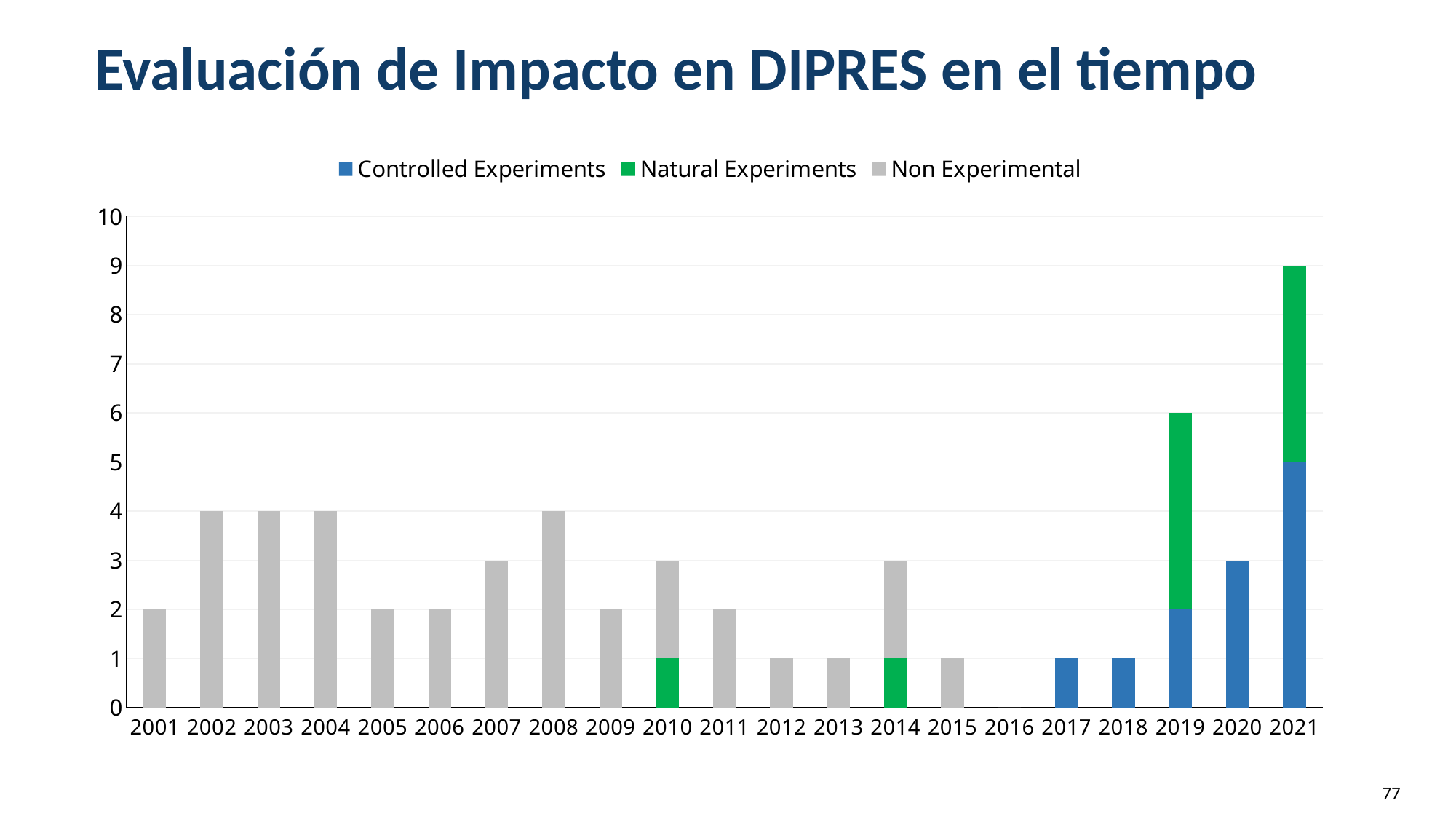
Which year has no bar at all? 2016 Is the total for 2019 greater or less than 5? greater Which year has the tallest stacked bar? 2021 How many years are shown on the x axis? 21 How many series does the legend list? 3 What is the value for Non Experimental in 2008? 4 What is the total height of the stacked bar for 2021? 9 What is the value for Controlled Experiments in 2020? 3 What kind of chart is shown on the slide? Stacked bar chart What is the total height of the stacked bar for 2019? 6 Which series is shown in green in the legend? Natural Experiments What is the value for Controlled Experiments in 2021? 5